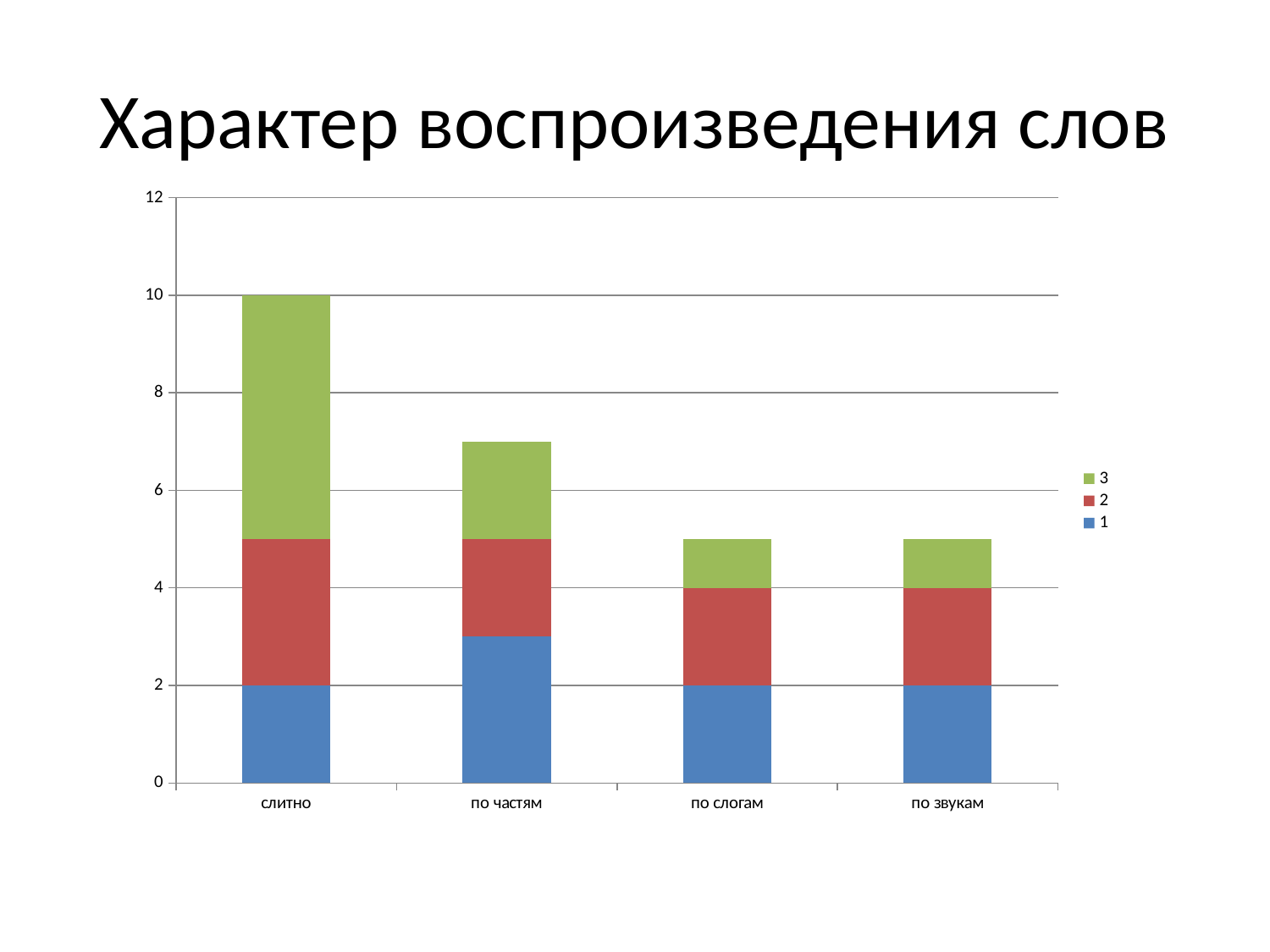
Do the total bar heights rise or fall from слитно to по звукам? fall Which has the larger total bar, слитно or по частям? слитно What is the title of the chart? Характер воспроизведения слов Is the total for по частям greater or less than 6? greater What is the total height of the stacked bar for слитно? 10 How many categories are shown on the x axis? 4 Is the total for по звукам greater or less than 6? less What kind of chart is shown on the slide? stacked bar chart How many series does the legend list? 3 What is the value of series 1 for по слогам? 2 Which category has the highest total bar? слитно What is the value of series 1 for слитно? 2